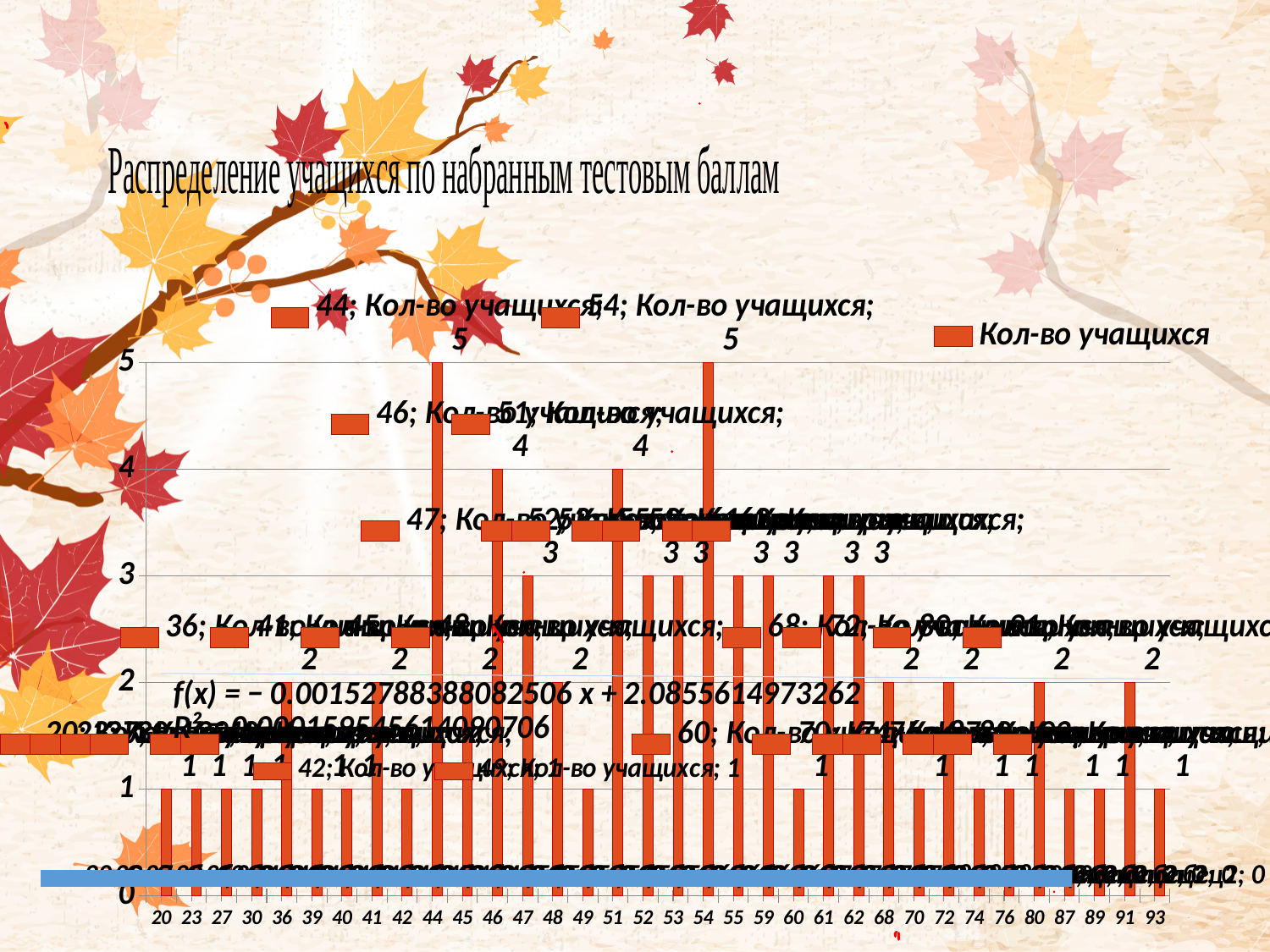
What is the title of the chart? Распределение учащихся по набранным тестовым баллам What is the highest number of students shown for any score? 5 What is the difference between the number of students for score 54 and for score 60? 4 Is the value for score 36 greater or less than 3? less What is the number of students for score 46? 4 How many series does the chart legend list? 1 What kind of chart is shown on the slide? bar chart Which score has more students, 44 or 47? 44 What is the number of students (Кол-во учащихся) for score 44? 5 What is the number of students for score 47? 3 What is the number of students for score 60? 1 What is the name of the series shown in the legend? Кол-во учащихся